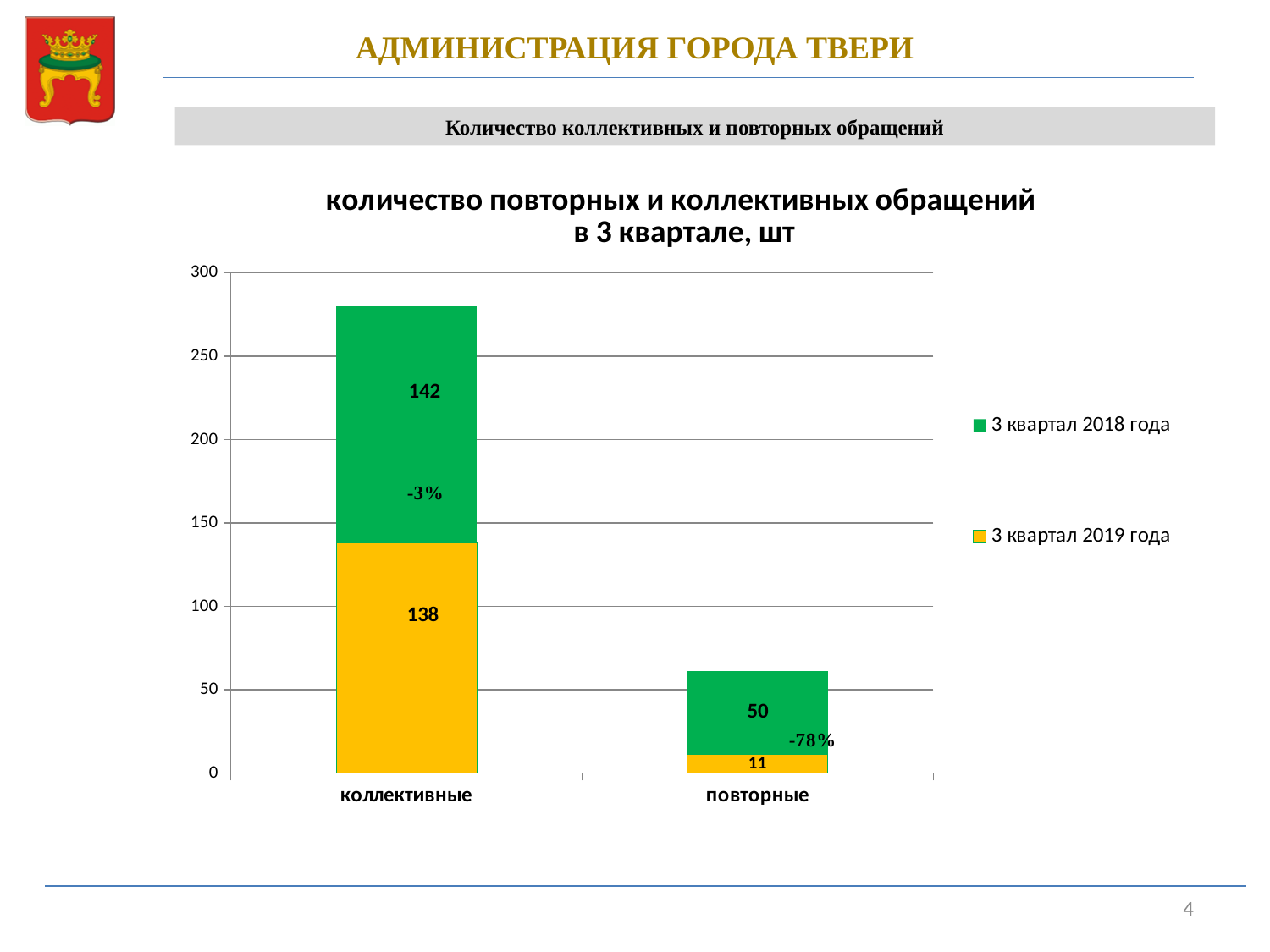
What is the total of the stacked bar for коллективные? 280 Which category has the higher value for 3 квартал 2019 года, коллективные or повторные? коллективные What is the value for 3 квартал 2019 года in the коллективные category? 138 What is the value for 3 квартал 2018 года in the коллективные category? 142 What is the difference between the 3 квартал 2018 года and 3 квартал 2019 года values for повторные? 39 What is the value for 3 квартал 2019 года in the повторные category? 11 How many series does the legend list? 2 What is the total of the stacked bar for повторные? 61 What is the value for 3 квартал 2018 года in the повторные category? 50 How many categories are shown on the x axis? 2 What kind of chart is shown on the slide? stacked bar chart Which category has the lowest value for 3 квартал 2018 года? повторные